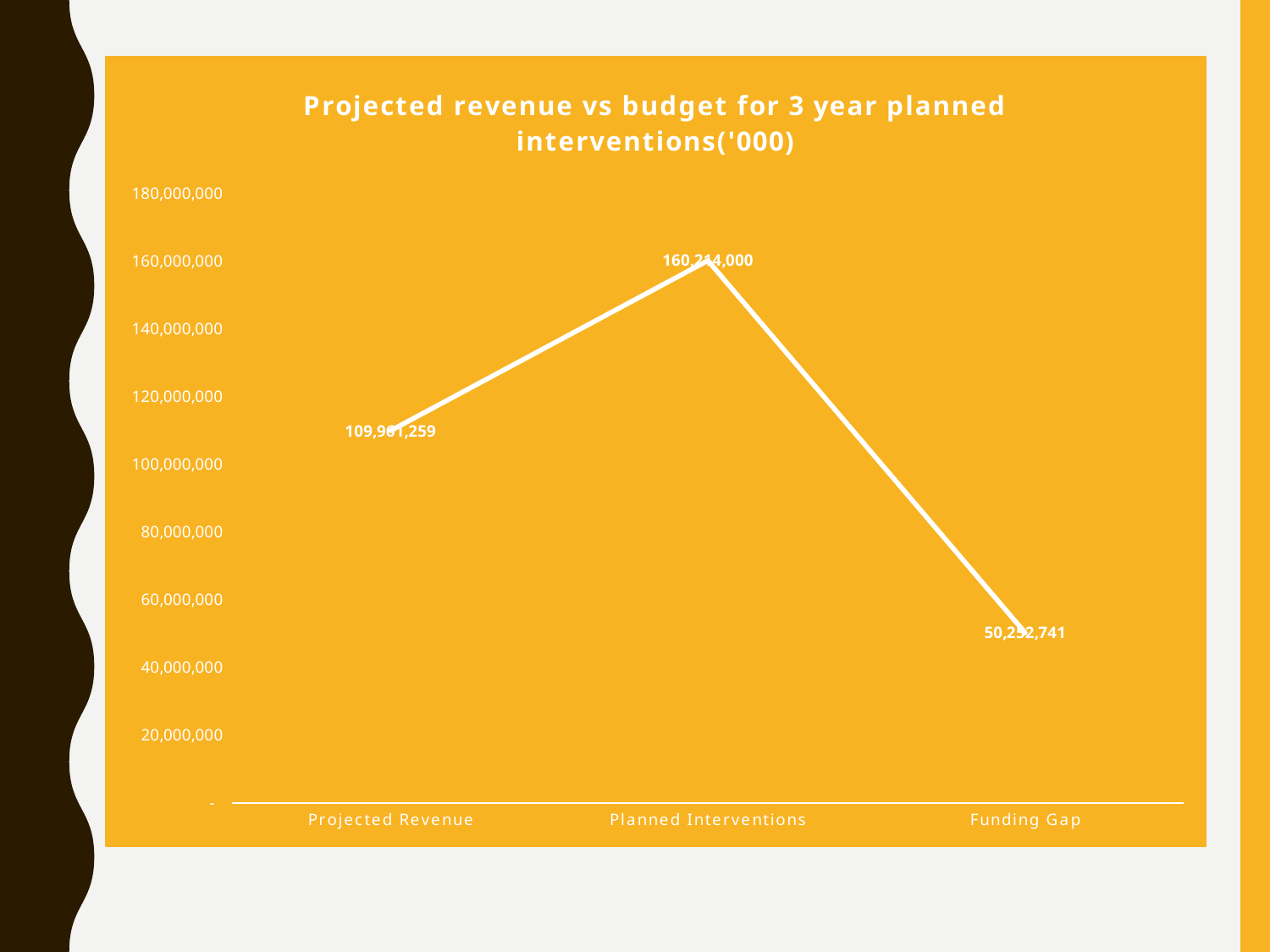
How many categories are plotted along the x axis? 3 Does the line rise or fall from Planned Interventions to Funding Gap? fall Which is larger, the value for Projected Revenue or the value for Funding Gap? Projected Revenue Which category has the lowest value? Funding Gap What is the highest value shown on the vertical axis? 180,000,000 Which is larger, the value for Projected Revenue or the value for Planned Interventions? Planned Interventions What is the title of the chart? Projected revenue vs budget for 3 year planned interventions('000) Is the value for Funding Gap greater or less than 60,000,000? less Which category has the highest value? Planned Interventions What kind of chart is shown on the slide? line chart Is the value for Planned Interventions greater or less than 140,000,000? greater Is the value for Projected Revenue greater or less than 100,000,000? greater